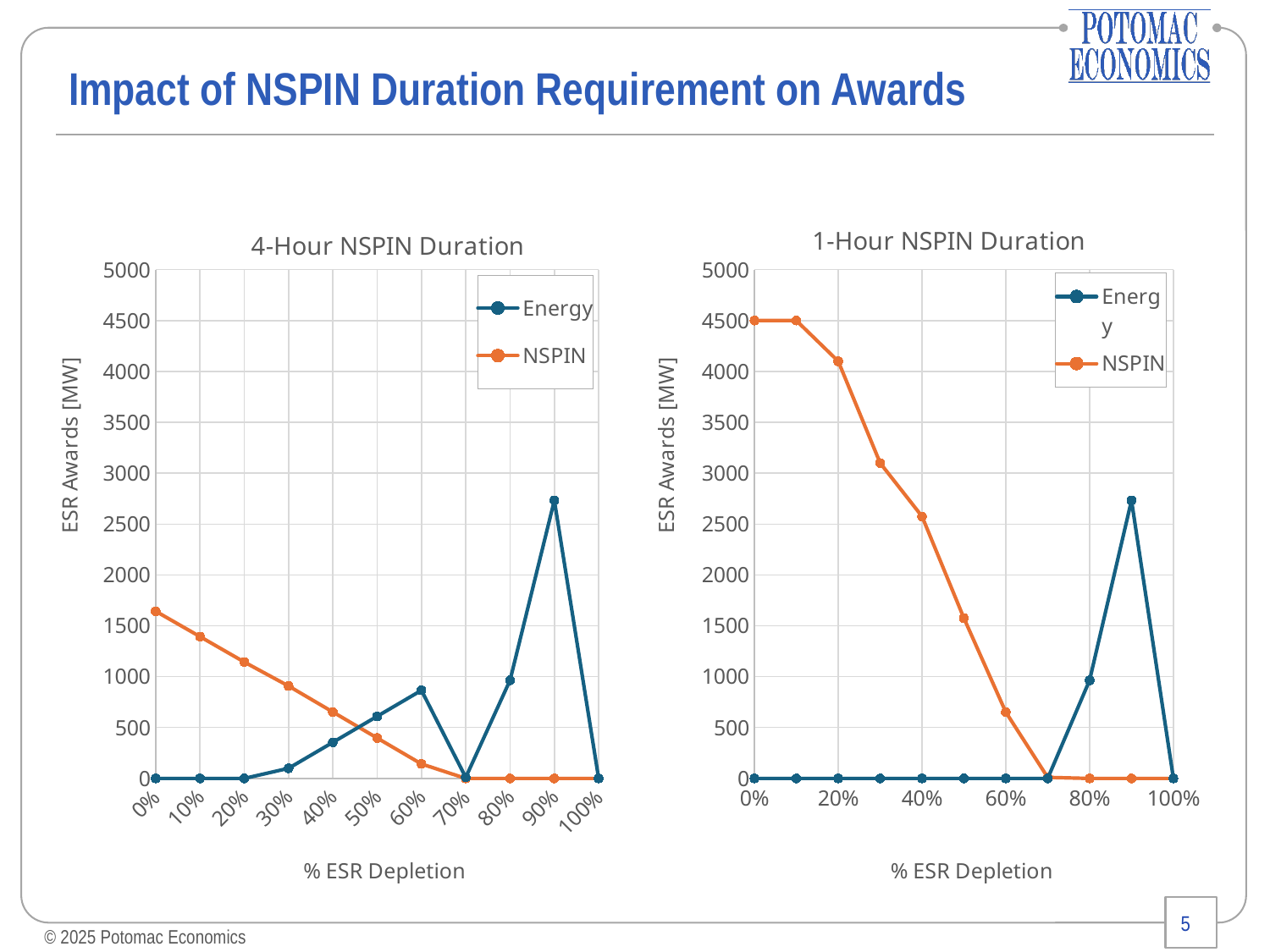
How many % ESR Depletion points are plotted along the x axis of the 4-Hour NSPIN Duration chart? 11 In the 4-Hour NSPIN Duration chart, at which % ESR Depletion is the NSPIN award highest? 0% What is the y-axis title of the 1-Hour NSPIN Duration chart? ESR Awards [MW] In the 4-Hour NSPIN Duration chart, is the NSPIN value at 0% ESR Depletion greater or less than 1500? greater In the 1-Hour NSPIN Duration chart, what is the NSPIN value at 0% ESR Depletion? 4500 How many series does the legend of the 1-Hour NSPIN Duration chart list? 2 What kind of chart is the 4-Hour NSPIN Duration chart? line chart In the 1-Hour NSPIN Duration chart, is the NSPIN value at 50% ESR Depletion greater or less than 2000? less In the 4-Hour NSPIN Duration chart, at which % ESR Depletion is the Energy award highest? 90% In the 4-Hour NSPIN Duration chart, does the NSPIN series rise or fall from 0% to 70% ESR Depletion? fall In the 1-Hour NSPIN Duration chart, which series has the larger value at 90% ESR Depletion, Energy or NSPIN? Energy